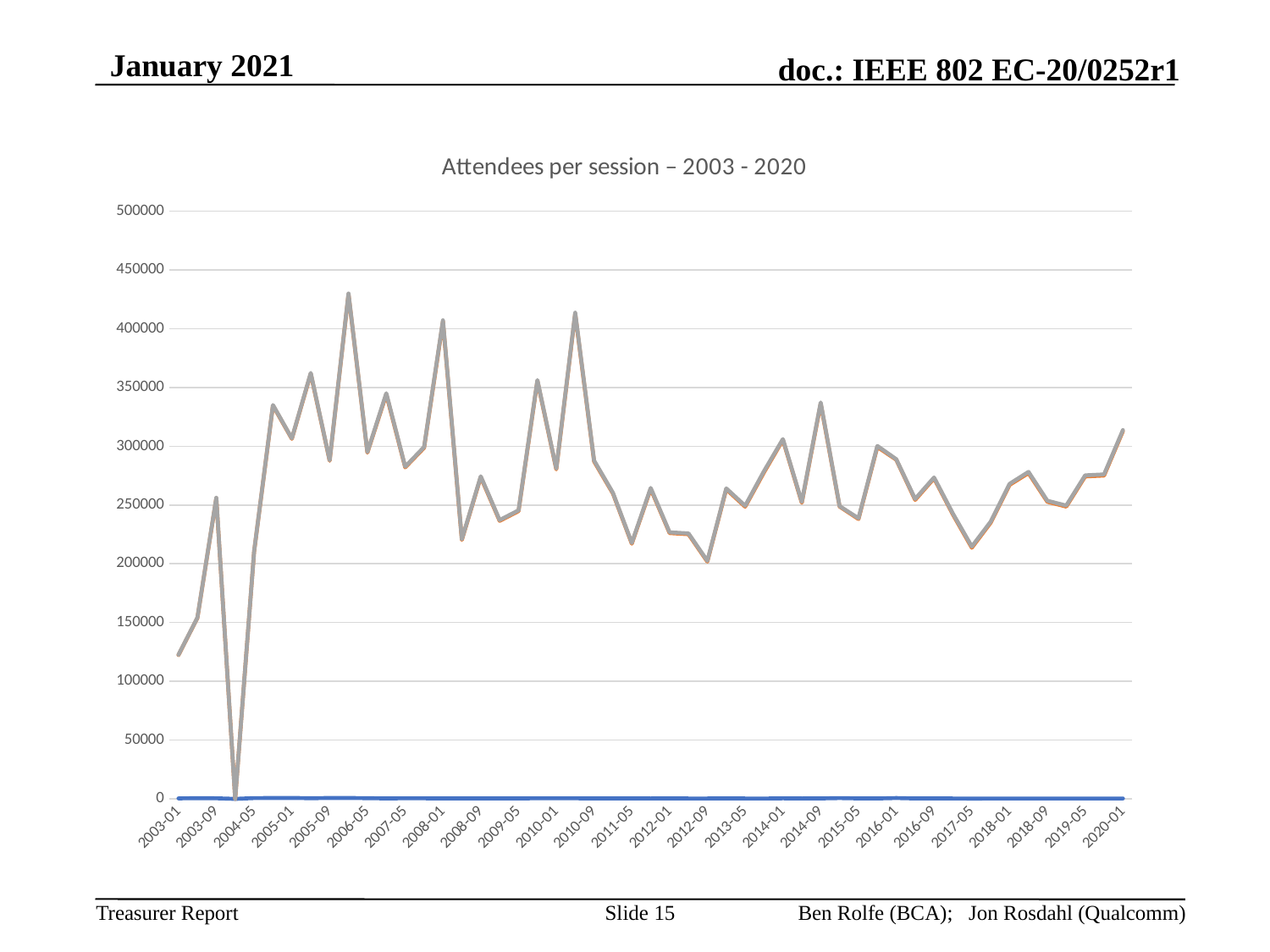
What is the title of the chart? Attendees per session – 2003 - 2020 Do the values rise or fall from 2017-05 to 2020-01? rise What kind of chart is shown on the slide? line chart Is the value for 2020-01 greater or less than 300000? greater Which has the larger value, 2020-01 or 2017-05? 2020-01 Which has the larger value, 2008-01 or 2003-01? 2008-01 Is the value for 2011-05 greater or less than 250000? less Is the value for 2005-01 greater or less than 300000? greater What is the highest value shown on the vertical axis? 500000